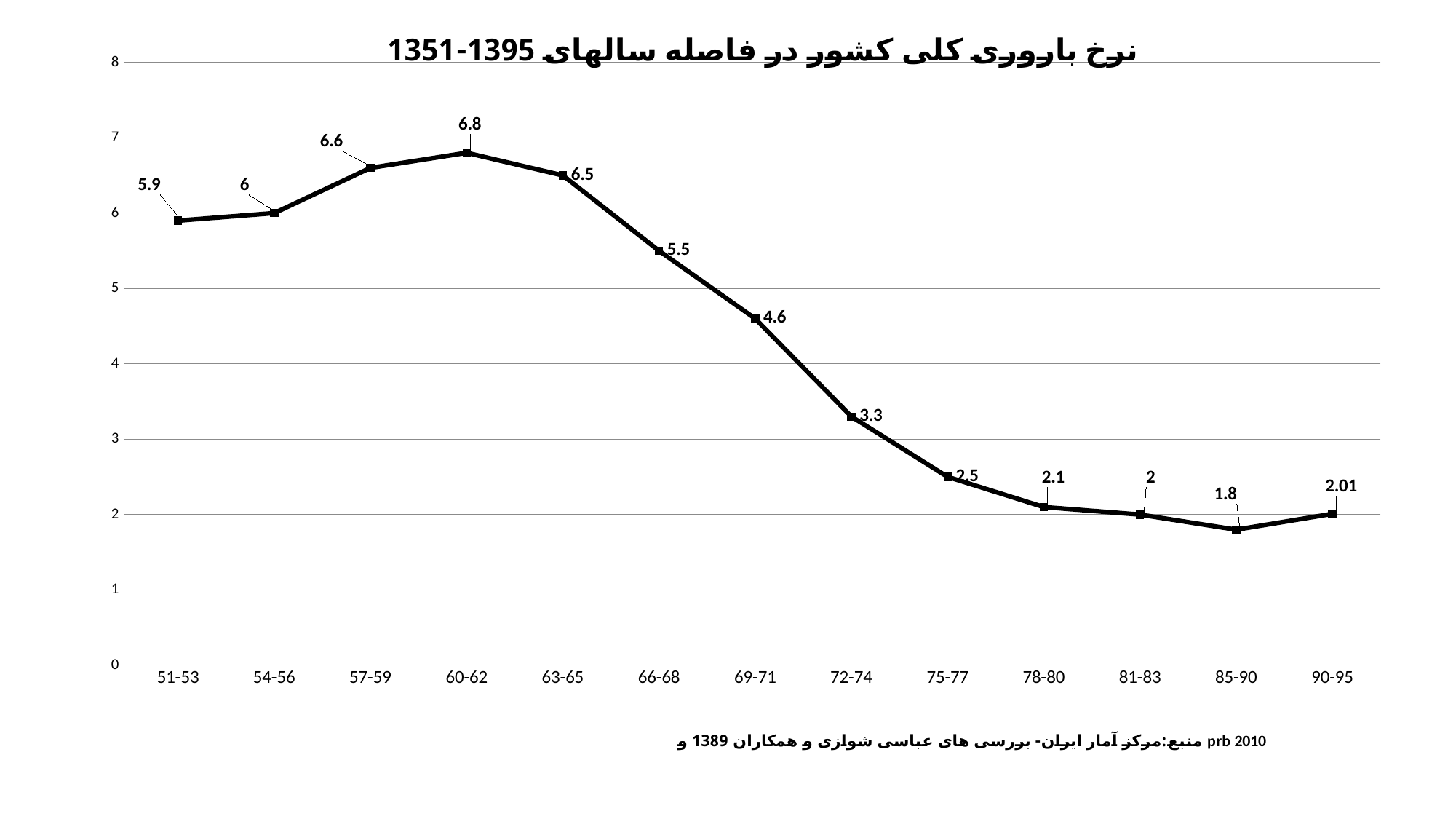
What is the difference between the values for 63-65 and 66-68? 1 Is the value for 69-71 greater or less than 5? less Which period has the lowest value? 85-90 What kind of chart is this? line chart What is the value for the 60-62 period? 6.8 Which period has the highest value? 60-62 What is the difference between the values for 60-62 and 85-90? 5 Which is larger, the value for 51-53 or the value for 57-59? 57-59 What is the value for the 72-74 period? 3.3 How many periods are shown on the x axis? 13 Do the values rise or fall from 63-65 to 85-90? fall What is the value for the 90-95 period? 2.01